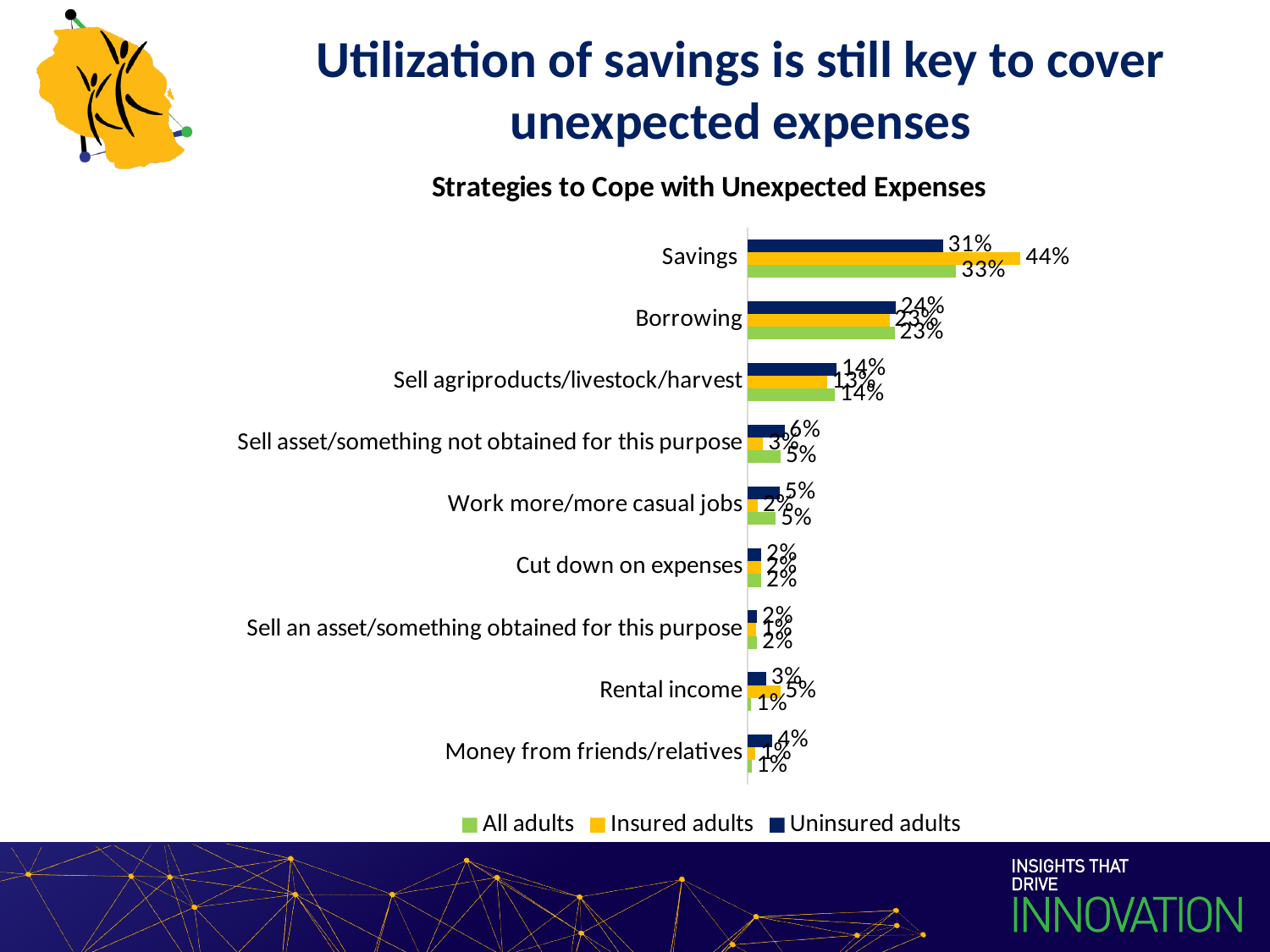
What is the difference between the Insured adults and Uninsured adults values for Savings? 13% What is the value for Insured adults for 'Work more/more casual jobs'? 2% How many coping strategies (categories) are shown in the chart? 9 What kind of chart is shown on the slide? Bar chart Which strategy has the highest value for Insured adults? Savings What is the title of the chart? Strategies to Cope with Unexpected Expenses What is the value for Uninsured adults for Savings? 31% What is the value for Uninsured adults for 'Sell asset/something not obtained for this purpose'? 6% What is the value for All adults for Savings? 33% For Rental income, which is larger: the Insured adults value or the All adults value? Insured adults What is the value for Insured adults for Savings? 44% How many series does the legend list? 3